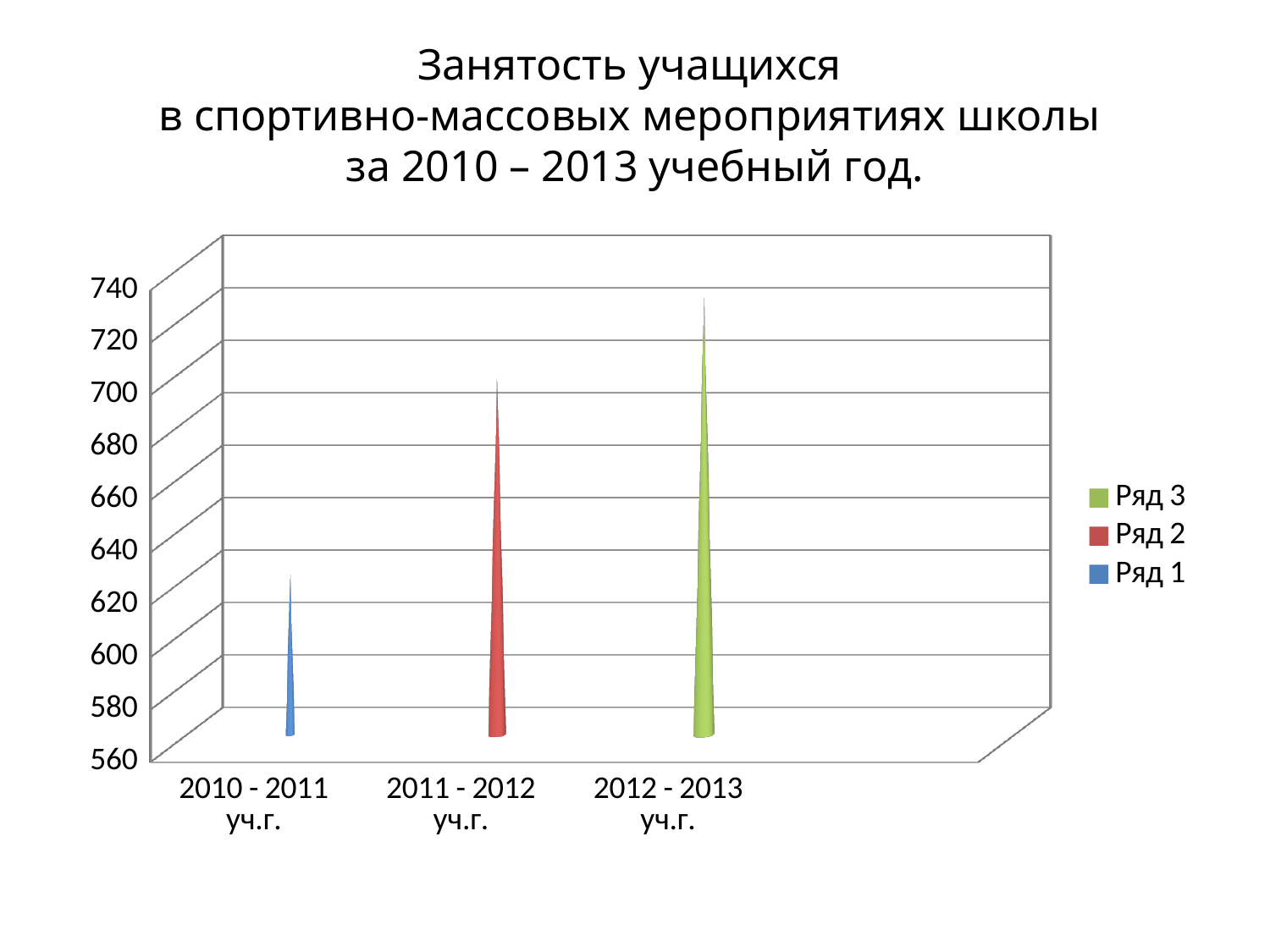
Is the value for 2010 - 2011 уч.г. greater or less than 660? less How many categories are shown on the x axis of the chart? 3 Which category has the lowest value? 2010 - 2011 уч.г. Which category has the highest value? 2012 - 2013 уч.г. Is the value for 2012 - 2013 уч.г. greater or less than 700? greater Is the value for 2011 - 2012 уч.г. greater or less than 680? greater What kind of chart is shown on the slide? bar chart Do the values rise or fall from 2010 - 2011 уч.г. to 2012 - 2013 уч.г.? rise Which is larger, the value for 2012 - 2013 уч.г. or the value for 2011 - 2012 уч.г.? 2012 - 2013 уч.г. How many series does the legend list? 3 Which is larger, the value for 2011 - 2012 уч.г. or the value for 2010 - 2011 уч.г.? 2011 - 2012 уч.г. Which legend entry is shown in green? Ряд 3